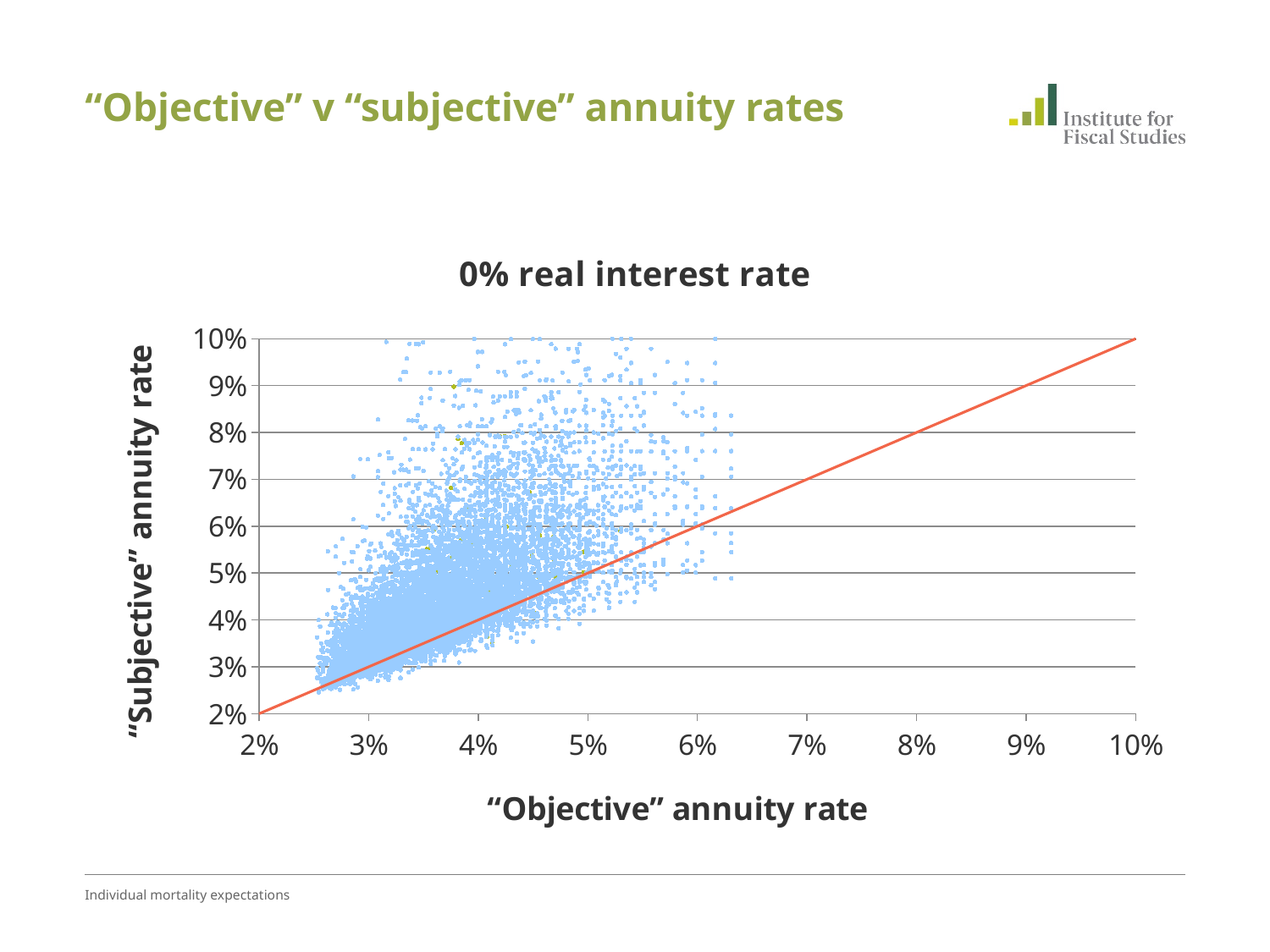
Is the smallest "objective" annuity rate among the scattered points greater or less than 2%? greater What is the spacing between consecutive tick marks on the vertical axis? 1% What kind of chart is shown on the slide? Scatter plot Are most of the scattered points above or below the red line? Above What is the highest value shown on the horizontal axis? 10% Do the scattered points generally rise or fall as the "objective" annuity rate increases? Rise Is the largest "objective" annuity rate among the scattered points greater or less than 7%? less At what vertical-axis value does the red line start at the left edge of the chart (2% on the horizontal axis)? 2% What is the lowest value shown on the vertical axis? 2% What is the label of the horizontal axis? "Objective" annuity rate At what vertical-axis value does the red line end at the right edge of the chart (10% on the horizontal axis)? 10% What is the title of the chart? 0% real interest rate